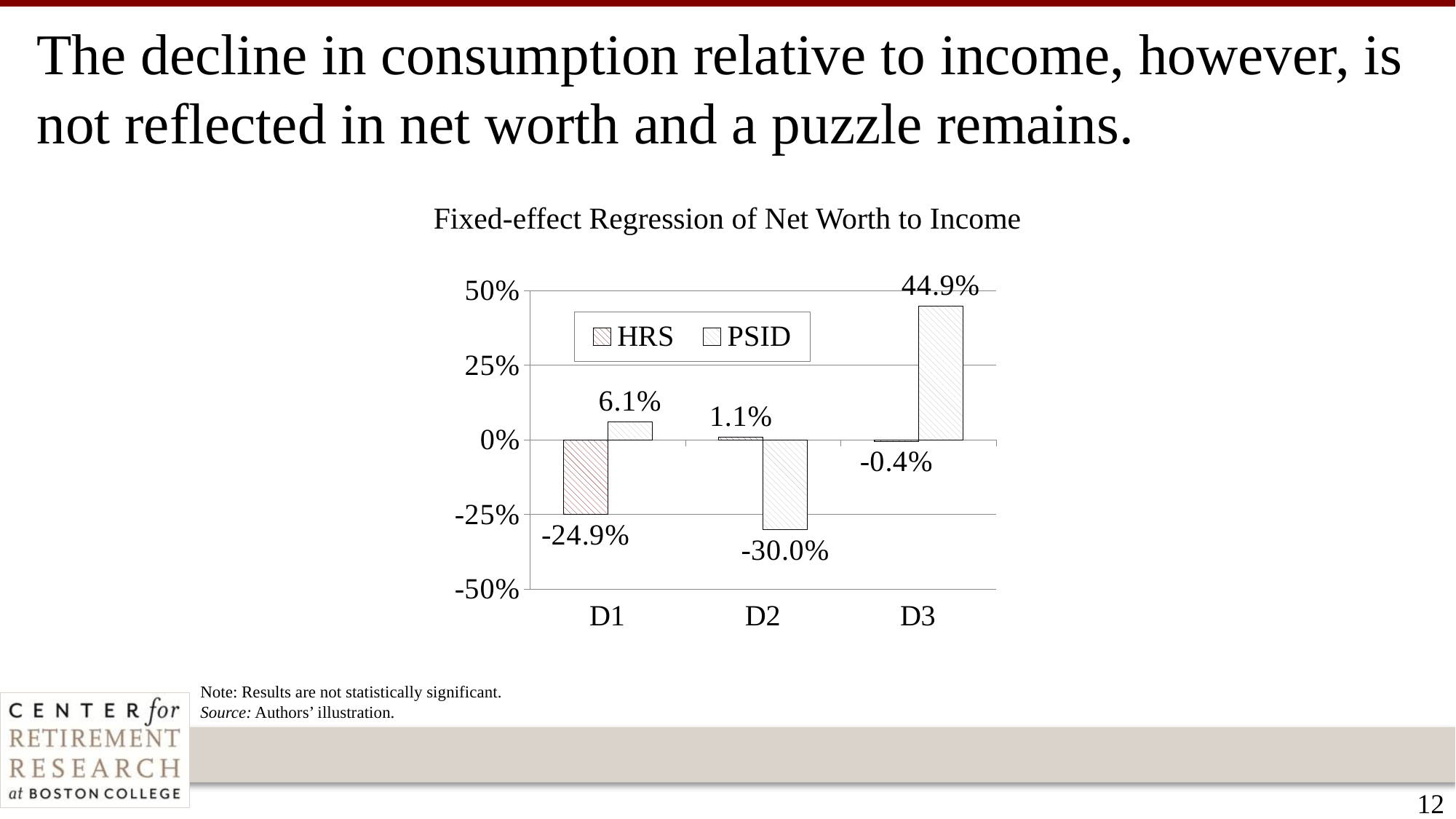
What is the HRS value for D3? -0.4% What is the PSID value for D3? 44.9% What kind of chart is shown on the slide? Bar chart How many categories are shown on the x axis? 3 What is the HRS value for D1? -24.9% How many series does the legend list? 2 What is the difference between the PSID value for D3 and the PSID value for D1? 38.8 percentage points What is the PSID value for D2? -30.0% Which category has the lowest HRS value? D1 Which is larger for D2, the HRS value or the PSID value? HRS Which category has the highest PSID value? D3 What is the title of the chart? Fixed-effect Regression of Net Worth to Income